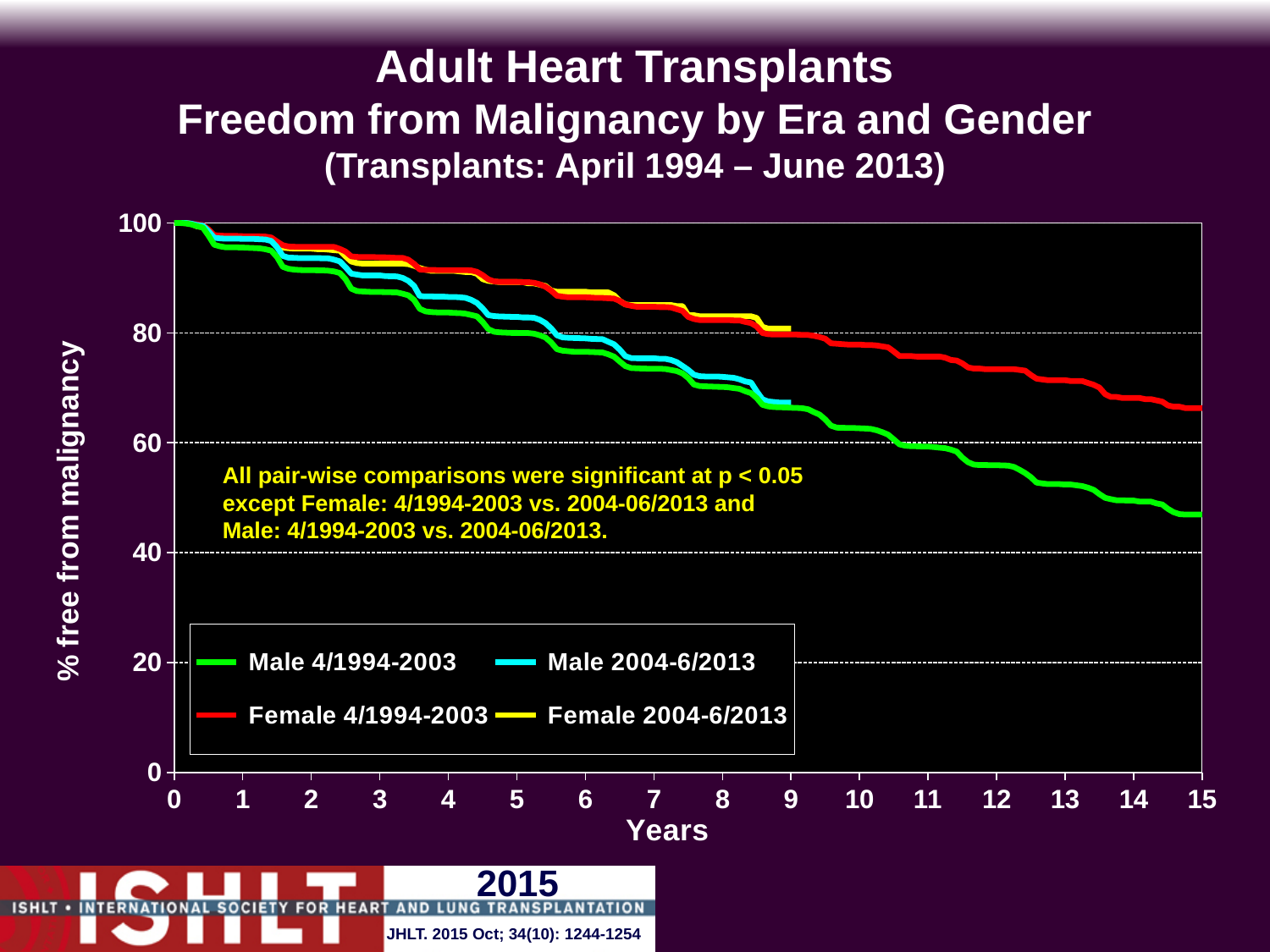
Is the value for Male 2004-6/2013 at 3 years greater or less than 80? greater Is the value for Male 4/1994-2003 at 15 years greater or less than 60? less Is the value for Female 4/1994-2003 at 15 years greater or less than 60? greater Do the values for Male 4/1994-2003 rise or fall as years increase? fall At 5 years, which is higher: Female 2004-6/2013 or Male 2004-6/2013? Female 2004-6/2013 What kind of chart is shown on the slide? line chart Which colour represents Female 4/1994-2003 in the legend? red What is the label of the y axis? % free from malignancy At 15 years, which is higher: Female 4/1994-2003 or Male 4/1994-2003? Female 4/1994-2003 How many series does the legend list? 4